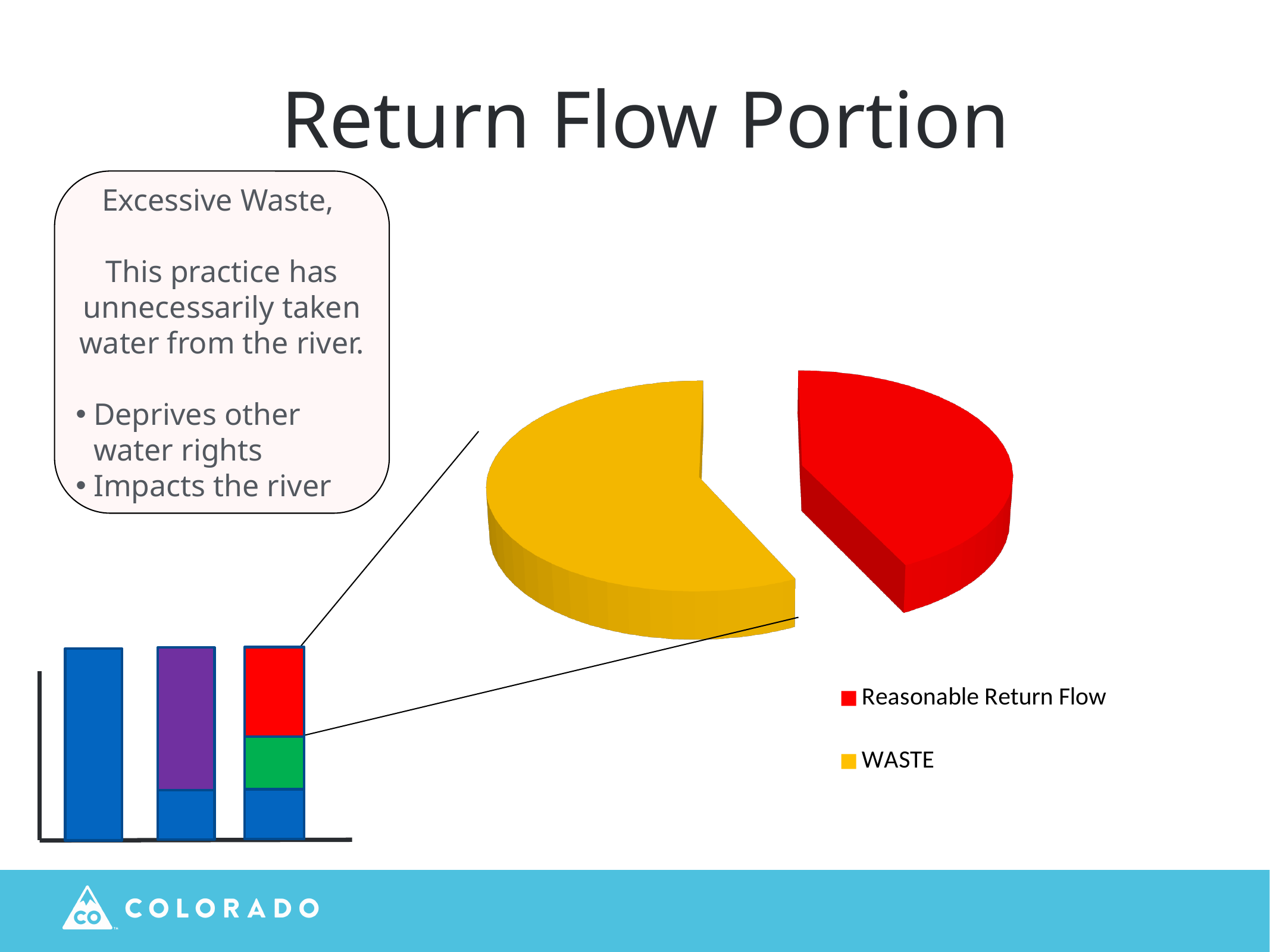
How many slices does the pie chart have? 2 What kind of chart is the large chart in the centre of the slide? Pie chart Which category has the largest slice in the pie chart? WASTE In the pie chart, which slice is larger, Reasonable Return Flow or WASTE? WASTE How many series does the legend of the pie chart list? 2 What colour is the Reasonable Return Flow slice in the pie chart? Red What colour is the WASTE slice in the pie chart? Yellow How many bars are in the bar chart in the bottom-left corner of the slide? 3 Which category has the smallest slice in the pie chart? Reasonable Return Flow What kind of chart is shown in the bottom-left corner of the slide? Bar chart